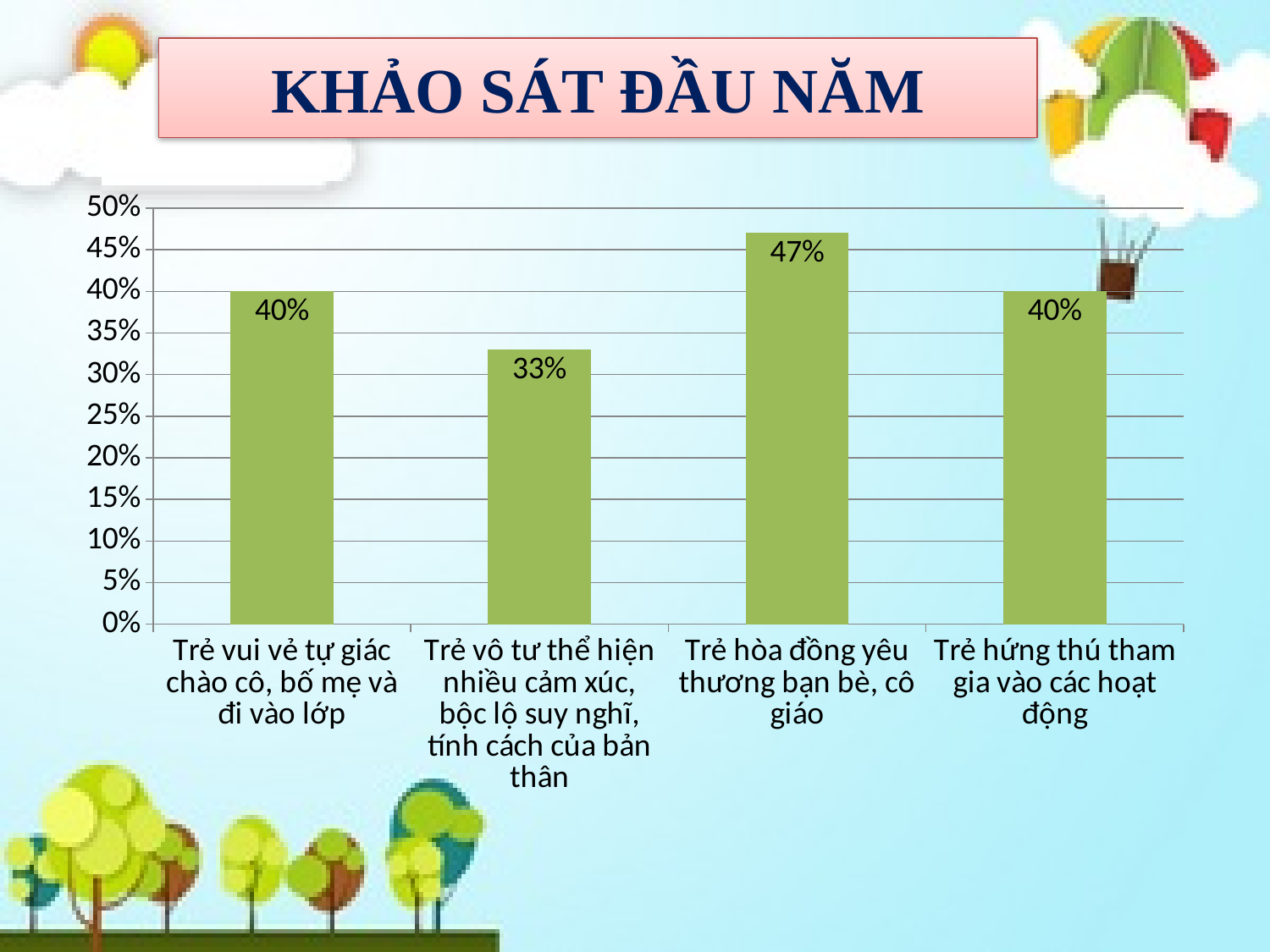
Which is larger: the value for "Trẻ hòa đồng yêu thương bạn bè, cô giáo" or the value for "Trẻ hứng thú tham gia vào các hoạt động"? Trẻ hòa đồng yêu thương bạn bè, cô giáo What is the title shown above the chart? KHẢO SÁT ĐẦU NĂM What is the value for "Trẻ vô tư thể hiện nhiều cảm xúc, bộc lộ suy nghĩ, tính cách của bản thân"? 33% What is the value for "Trẻ hứng thú tham gia vào các hoạt động"? 40% Which category has the lowest value? Trẻ vô tư thể hiện nhiều cảm xúc, bộc lộ suy nghĩ, tính cách của bản thân What is the difference between the values for "Trẻ hòa đồng yêu thương bạn bè, cô giáo" and "Trẻ vô tư thể hiện nhiều cảm xúc, bộc lộ suy nghĩ, tính cách của bản thân"? 14% What is the value for "Trẻ vui vẻ tự giác chào cô, bố mẹ và đi vào lớp"? 40% Is the value for "Trẻ vô tư thể hiện nhiều cảm xúc, bộc lộ suy nghĩ, tính cách của bản thân" greater or less than 35%? less What kind of chart is shown on the slide? bar chart Which category has the highest value? Trẻ hòa đồng yêu thương bạn bè, cô giáo How many categories are shown on the x axis? 4 What is the value for "Trẻ hòa đồng yêu thương bạn bè, cô giáo"? 47%